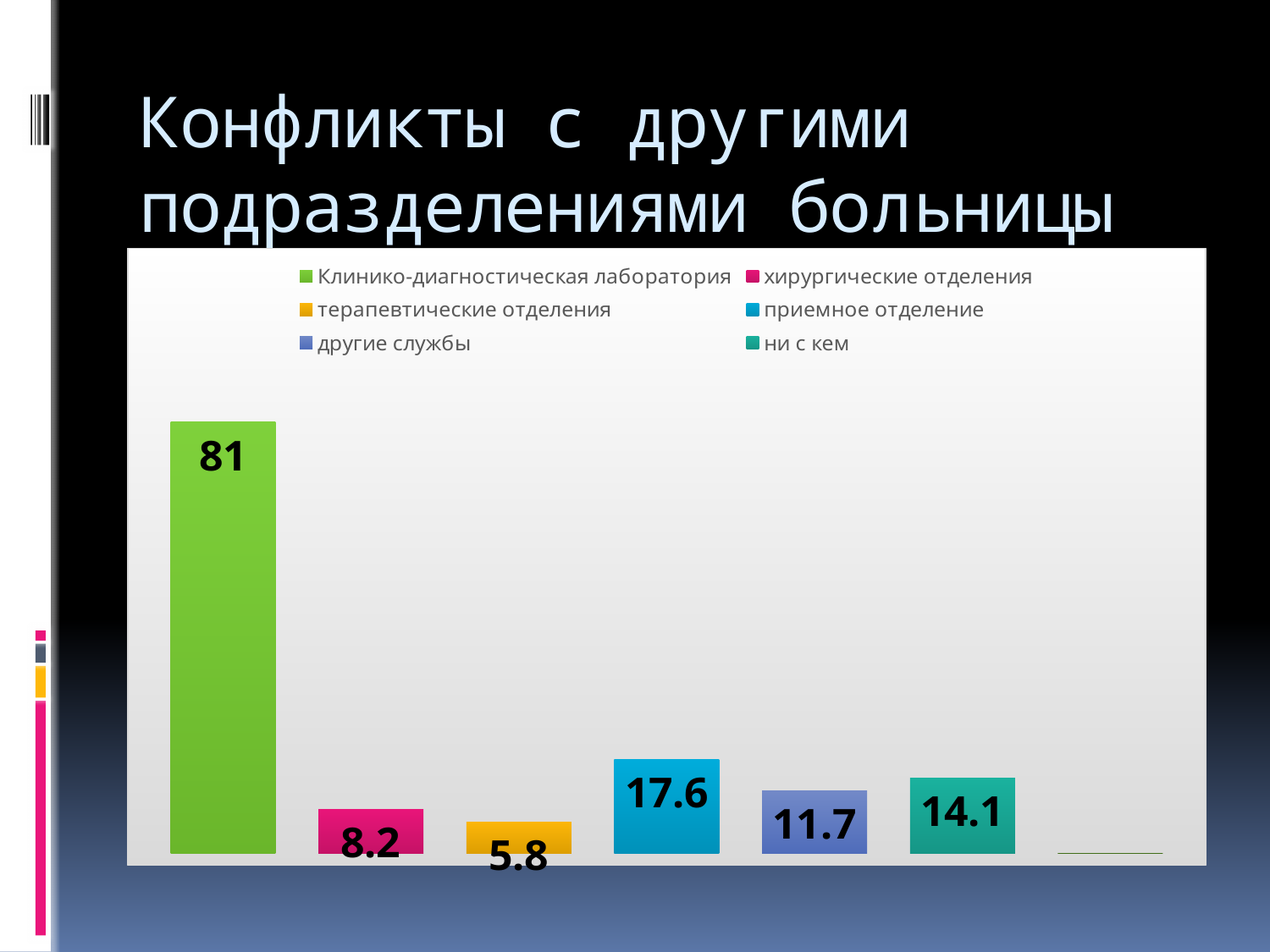
Which category has the highest value? Клинико-диагностическая лаборатория What value is shown for ни с кем? 14.1 Which is larger, the value for ни с кем or the value for другие службы? ни с кем What is the difference between the values for хирургические отделения and терапевтические отделения? 2.4 What value is shown for терапевтические отделения? 5.8 What value is shown for Клинико-диагностическая лаборатория? 81 How many series does the legend list? 6 Which category has the lowest labelled value? терапевтические отделения What is the difference between the values for приемное отделение and другие службы? 5.9 What value is shown for приемное отделение? 17.6 What kind of chart is shown on the slide? bar chart What colour is the bar for приемное отделение? blue